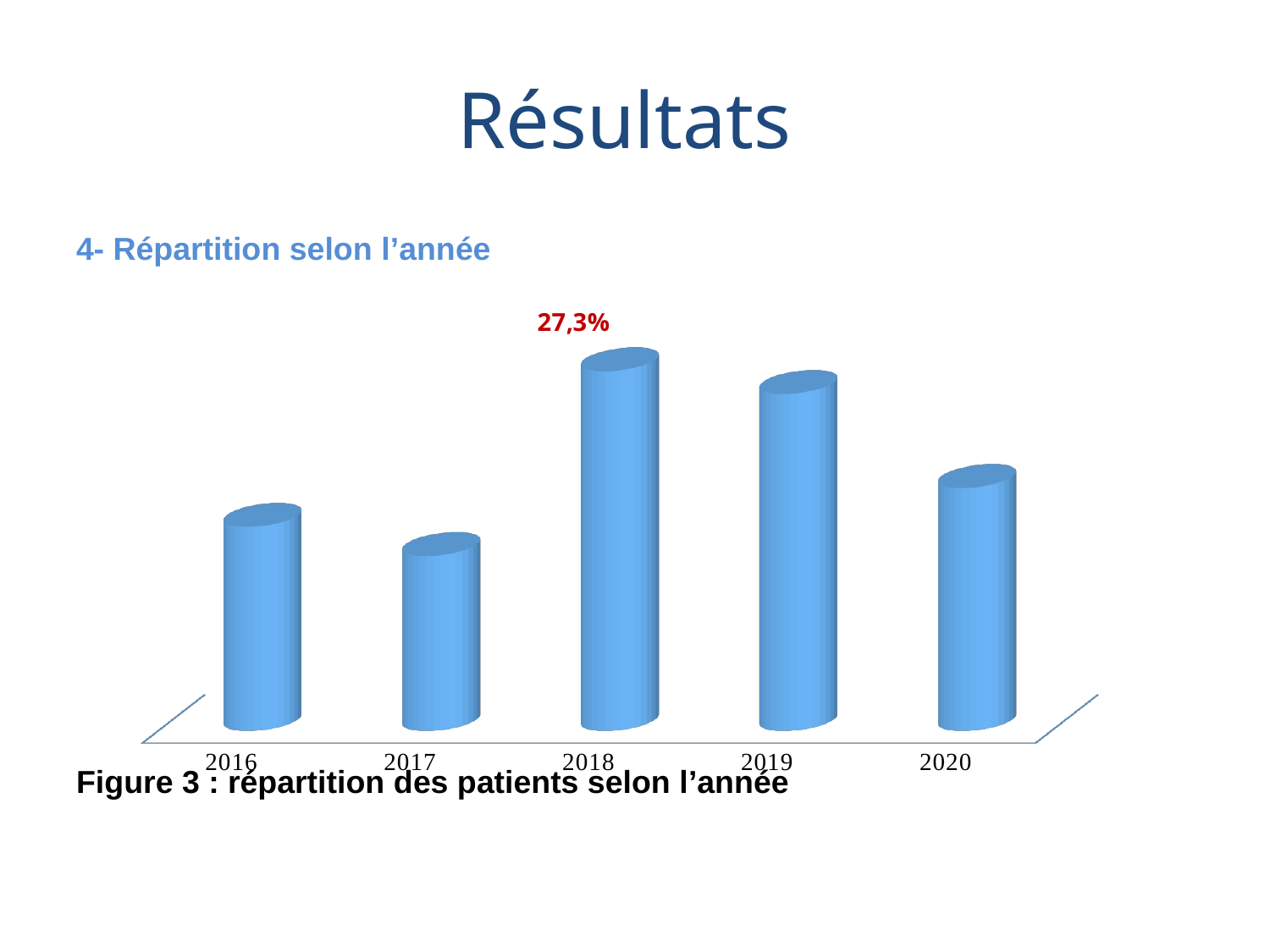
What kind of chart is shown on the slide? bar chart Which year has the lowest bar? 2017 What is the figure caption printed below the chart? Figure 3 : répartition des patients selon l'année What value is printed above the bar for 2018? 27,3% Do the bars rise or fall from 2018 to 2020? fall Which bar is taller, 2019 or 2020? 2019 How many years are shown on the x axis of the chart? 5 Do the bars rise or fall from 2017 to 2018? rise Which bar is taller, 2016 or 2017? 2016 Which bar is taller, 2018 or 2019? 2018 What colour is the data label printed above the 2018 bar? red Which year has the highest bar? 2018